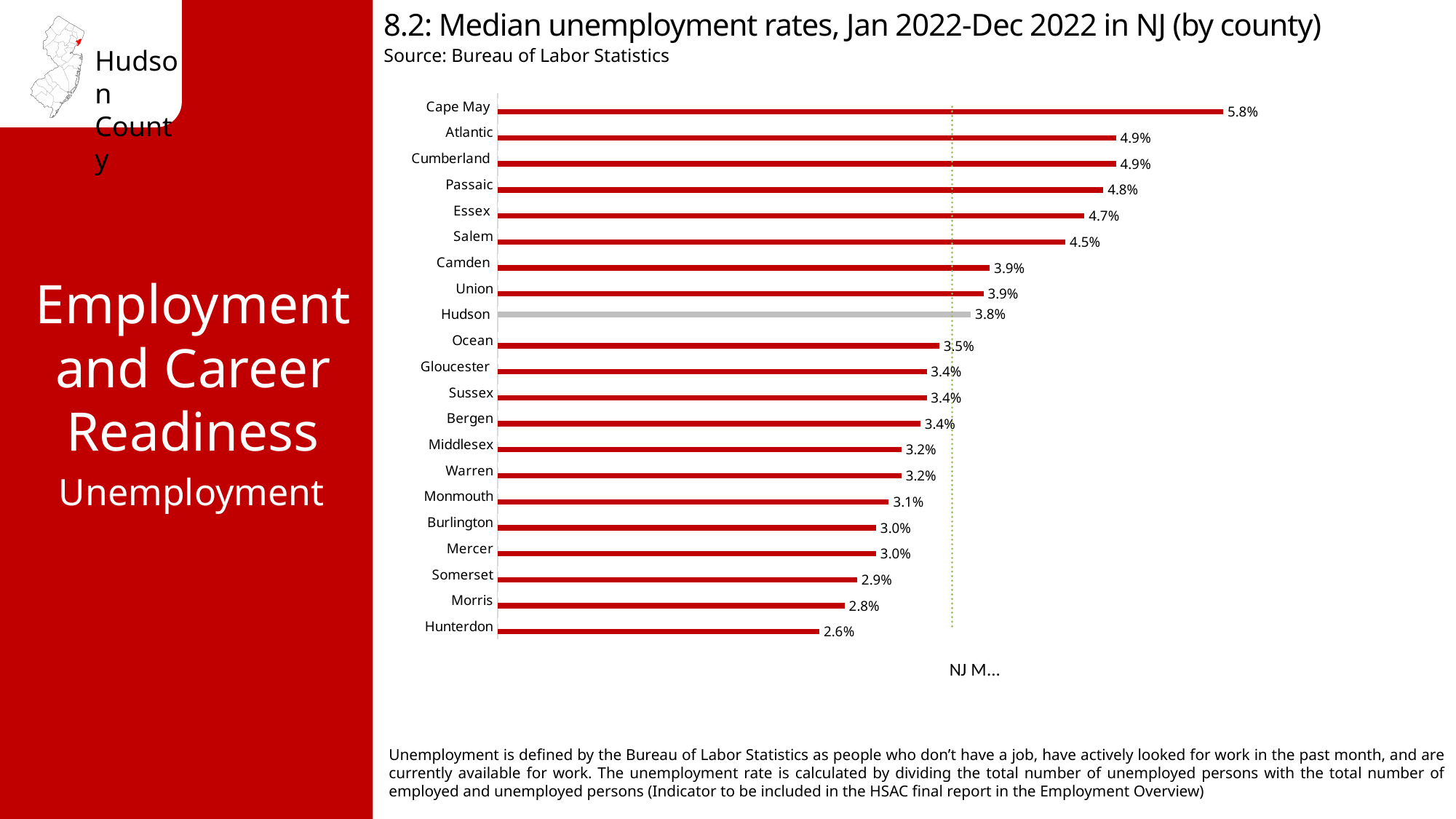
How many counties are shown in the chart? 21 What is the median unemployment rate for Hunterdon? 2.6% What kind of chart is shown on the slide? Bar chart What is the difference between the median unemployment rates of Cape May and Hunterdon? 3.2% Which has a higher median unemployment rate, Essex or Camden? Essex Which county's bar is shown in grey instead of red? Hudson Which county has the lowest median unemployment rate? Hunterdon What is the difference between the median unemployment rates of Hudson and Salem? 0.7% Which has a higher median unemployment rate, Hudson or Morris? Hudson What is the median unemployment rate for Hudson County? 3.8% Which county has the highest median unemployment rate? Cape May What is the median unemployment rate for Cape May? 5.8%